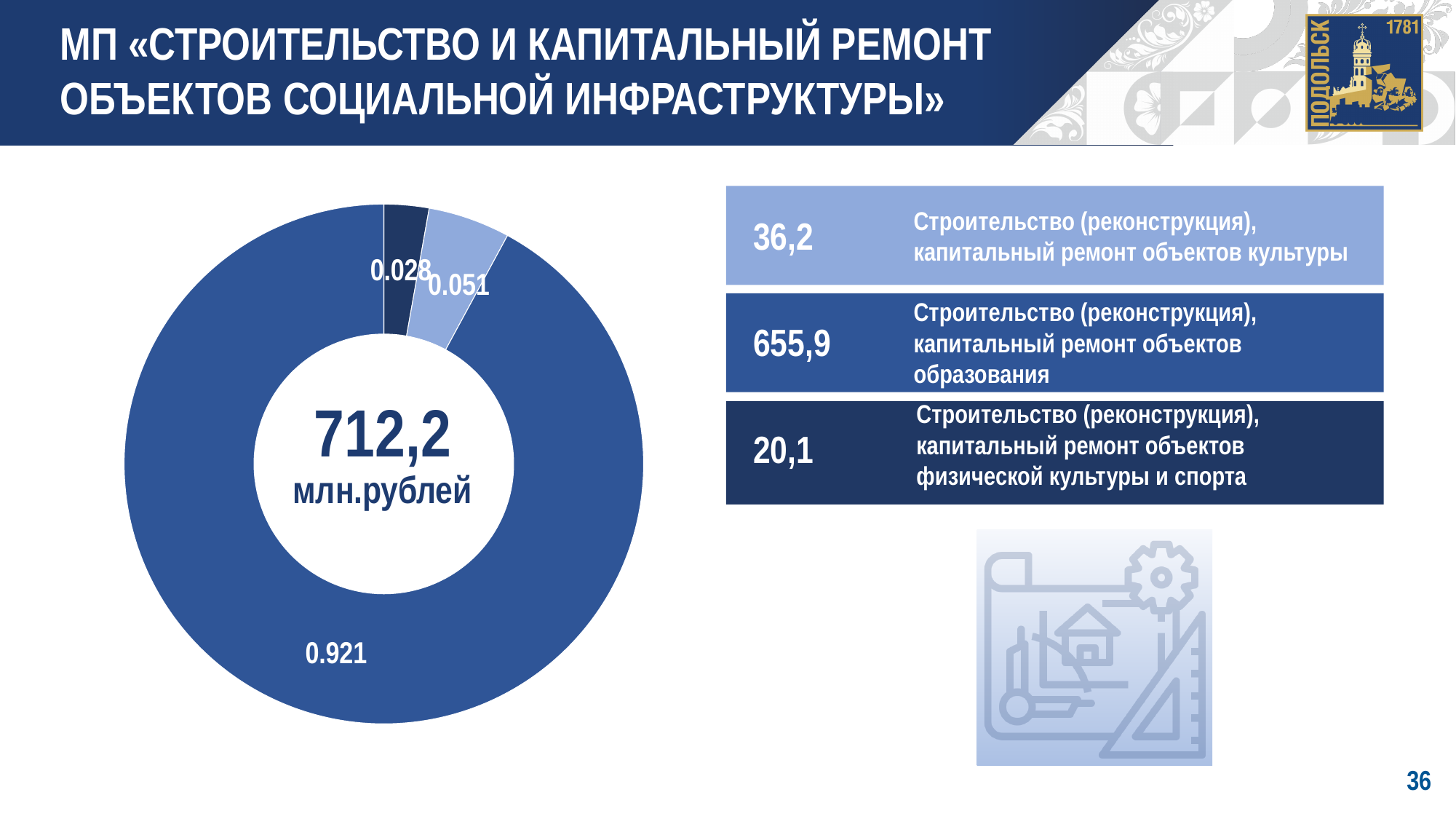
Which category has the largest value? Строительство (реконструкция), капитальный ремонт объектов образования What is the value for «Строительство (реконструкция), капитальный ремонт объектов образования»? 655,9 How many slices does the donut chart have? 3 What share of the donut chart is labelled for the largest slice (объекты образования)? 0.921 What share label is shown on the light blue slice (объекты культуры)? 0.051 What is the value for «Строительство (реконструкция), капитальный ремонт объектов культуры»? 36,2 What total value is printed in the centre of the donut chart? 712,2 млн.рублей Which category has the smallest value? Строительство (реконструкция), капитальный ремонт объектов физической культуры и спорта What share label is shown on the dark navy slice (объекты физической культуры и спорта)? 0.028 What is the difference between the value for объекты культуры (36,2) and объекты физической культуры и спорта (20,1)? 16,1 What kind of chart is shown on the slide? Donut (pie) chart Which is larger: the value for объекты культуры or for объекты физической культуры и спорта? объекты культуры